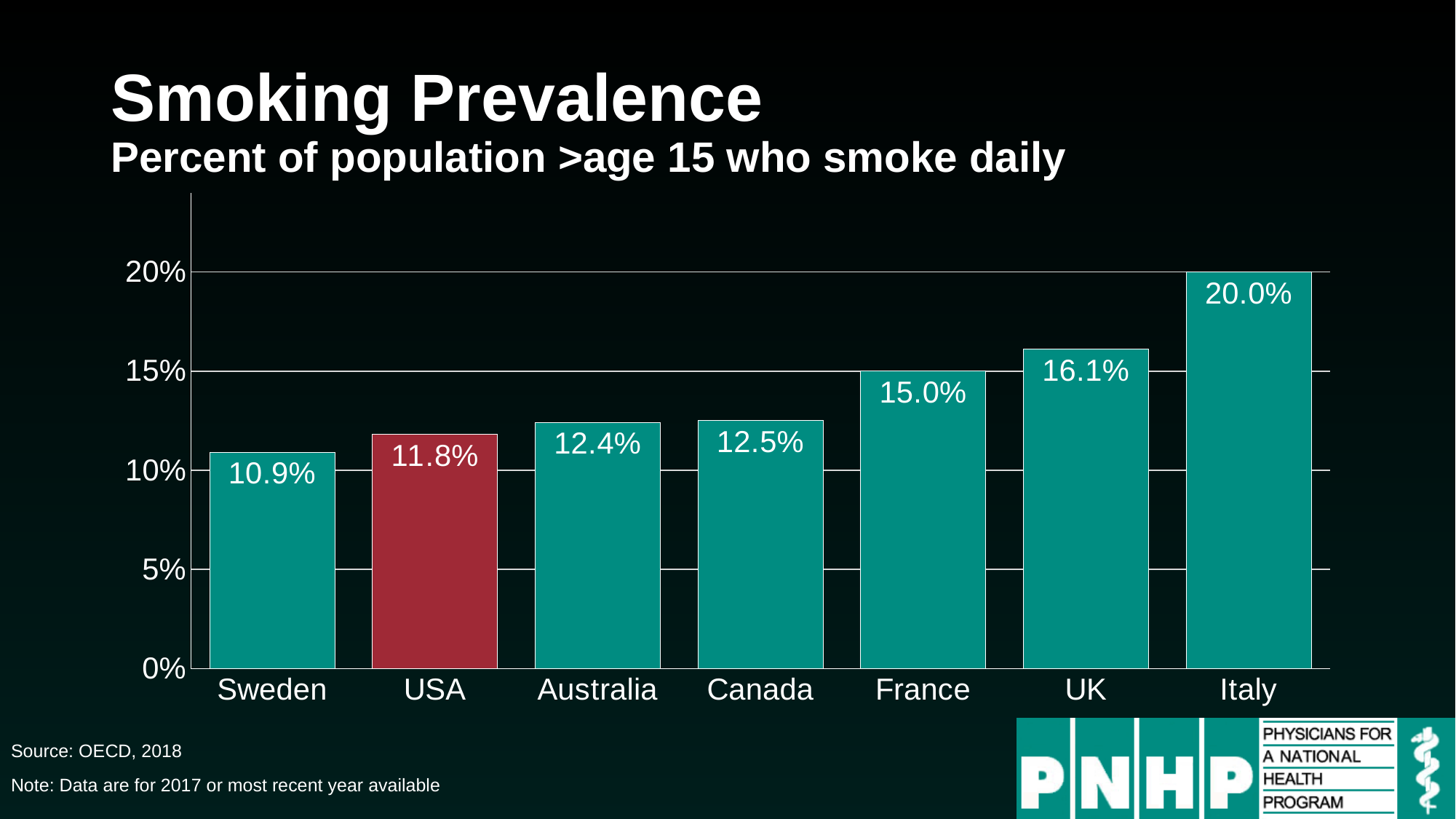
Which country has the lowest smoking prevalence on the chart? Sweden Which country has the highest smoking prevalence on the chart? Italy Which country's bar is shown in a different colour (red) from the others? USA What is the difference in smoking prevalence between Italy and Sweden? 9.1% Which has a higher smoking prevalence, France or Australia? France What kind of chart is shown on the slide? Bar chart What is the difference in smoking prevalence between the UK and the USA? 4.3% What is the smoking prevalence shown for the USA? 11.8% How many countries are shown on the chart? 7 What is the smoking prevalence shown for the UK? 16.1% Is the value for Canada greater or less than 15%? less What is the smoking prevalence shown for France? 15.0%